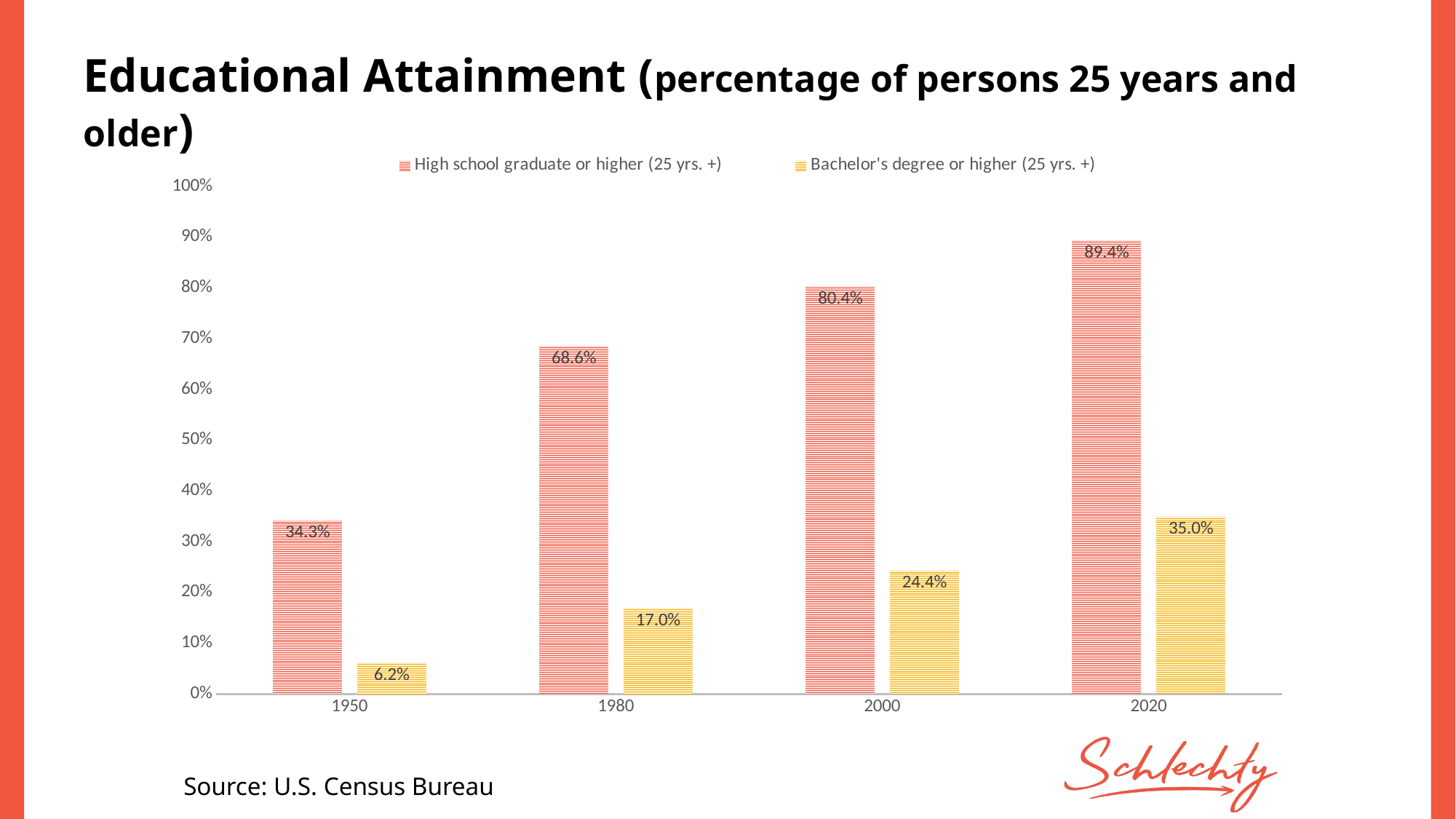
Which year has the lowest value for Bachelor's degree or higher? 1950 How many years are shown on the x axis? 4 Do the Bachelor's degree or higher values rise or fall from 1950 to 2020? Rise How many series does the legend list? 2 Which year has the highest value for High school graduate or higher? 2020 Is the value for High school graduate or higher in 2000 greater or less than 70%? greater What is the difference between the High school graduate or higher value and the Bachelor's degree or higher value in 2020? 54.4% What is the value for High school graduate or higher in 1980? 68.6% What is the value for Bachelor's degree or higher in 2000? 24.4% What is the value for Bachelor's degree or higher in 1950? 6.2% What kind of chart is shown on the slide? Bar chart Which is larger: the High school graduate or higher value in 1950 or the Bachelor's degree or higher value in 2020? Bachelor's degree or higher in 2020